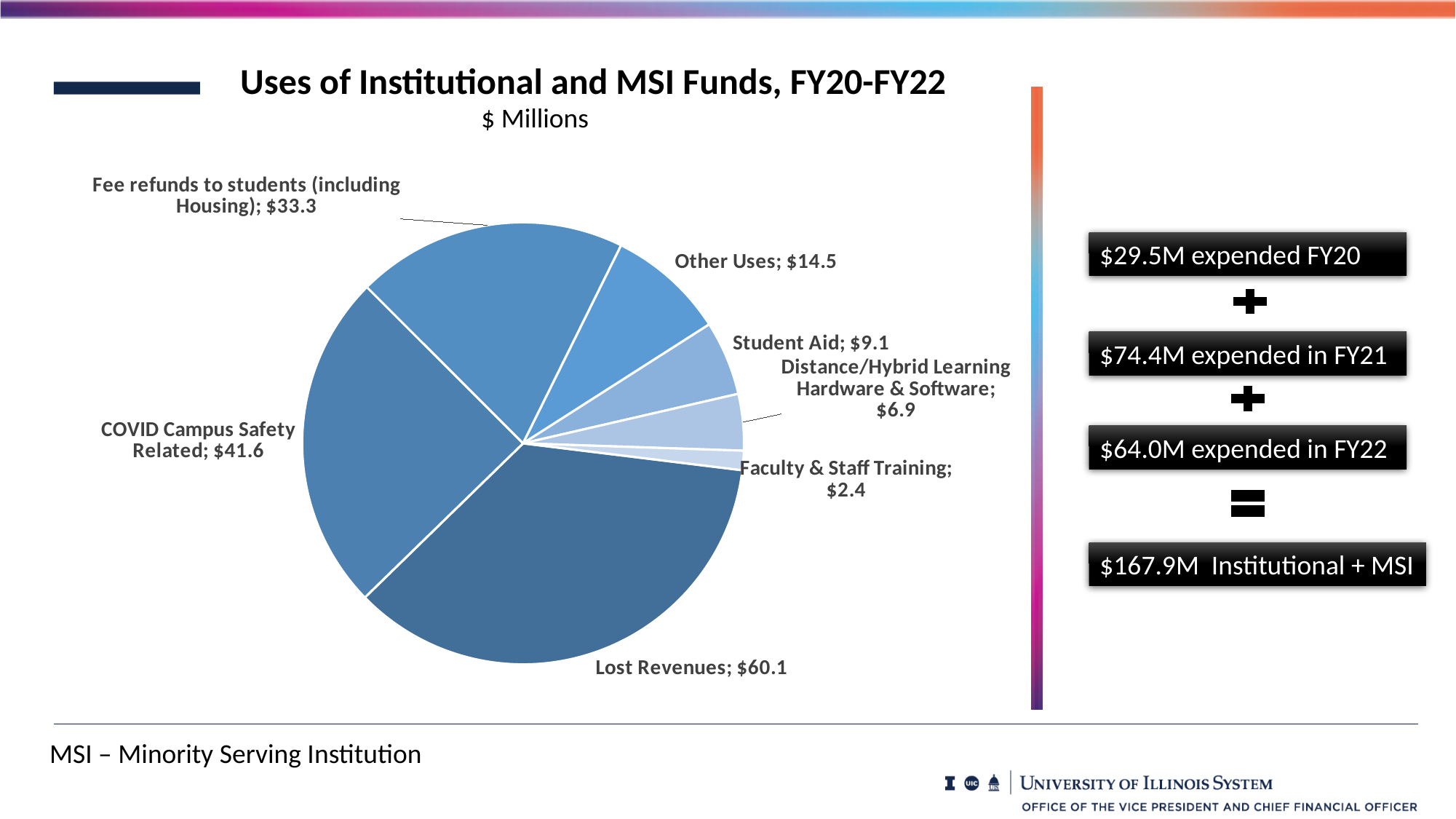
What type of chart is shown on the slide? Pie chart What is the value for Distance/Hybrid Learning Hardware & Software? $6.9 What is the difference between Lost Revenues and COVID Campus Safety Related? $18.5 What unit is stated under the chart title? $ Millions What is the difference between Fee refunds to students (including Housing) and Other Uses? $18.8 What is the value for COVID Campus Safety Related? $41.6 Which category has the smallest slice of the pie? Faculty & Staff Training What is the value for Lost Revenues? $60.1 How many categories are shown in the pie chart? 7 Which is larger, Other Uses or Student Aid? Other Uses Which category has the largest slice of the pie? Lost Revenues What is the value for Student Aid? $9.1